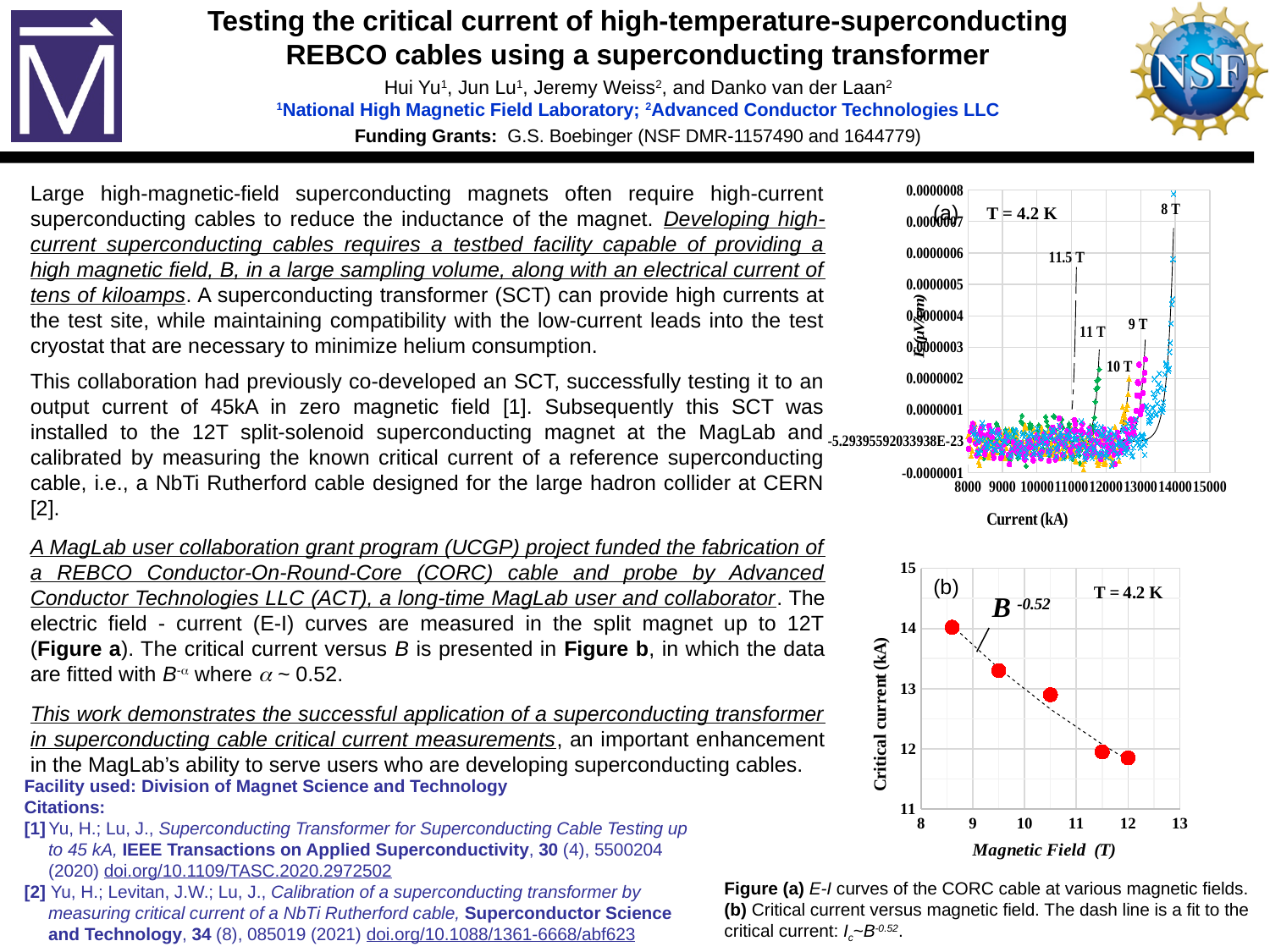
In Figure (b), is the critical current at 12 T greater or less than 13 kA? less What kind of chart is Figure (b), the critical current versus magnetic field plot? scatter chart In Figure (a), what is the label of the x axis? Current (kA) In Figure (b), is the critical current at the lowest magnetic field (about 8.6 T) greater or less than 13 kA? greater In Figure (b), what temperature is stated on the chart? T = 4.2 K In Figure (b), do the critical current values rise or fall as the magnetic field increases? fall In Figure (b), which has the higher critical current: the point near 9.5 T or the point near 11.5 T? the point near 9.5 T In Figure (b), what is the label of the y axis? Critical current (kA) In Figure (a), how many different magnetic field values are labelled on the E-I curves? 5 In Figure (a), which labelled magnetic field curve rises at the lowest current: 8 T or 11.5 T? 11.5 T What kind of chart is Figure (a), the E-I curves plot? scatter chart In Figure (b), how many data points are plotted? 5